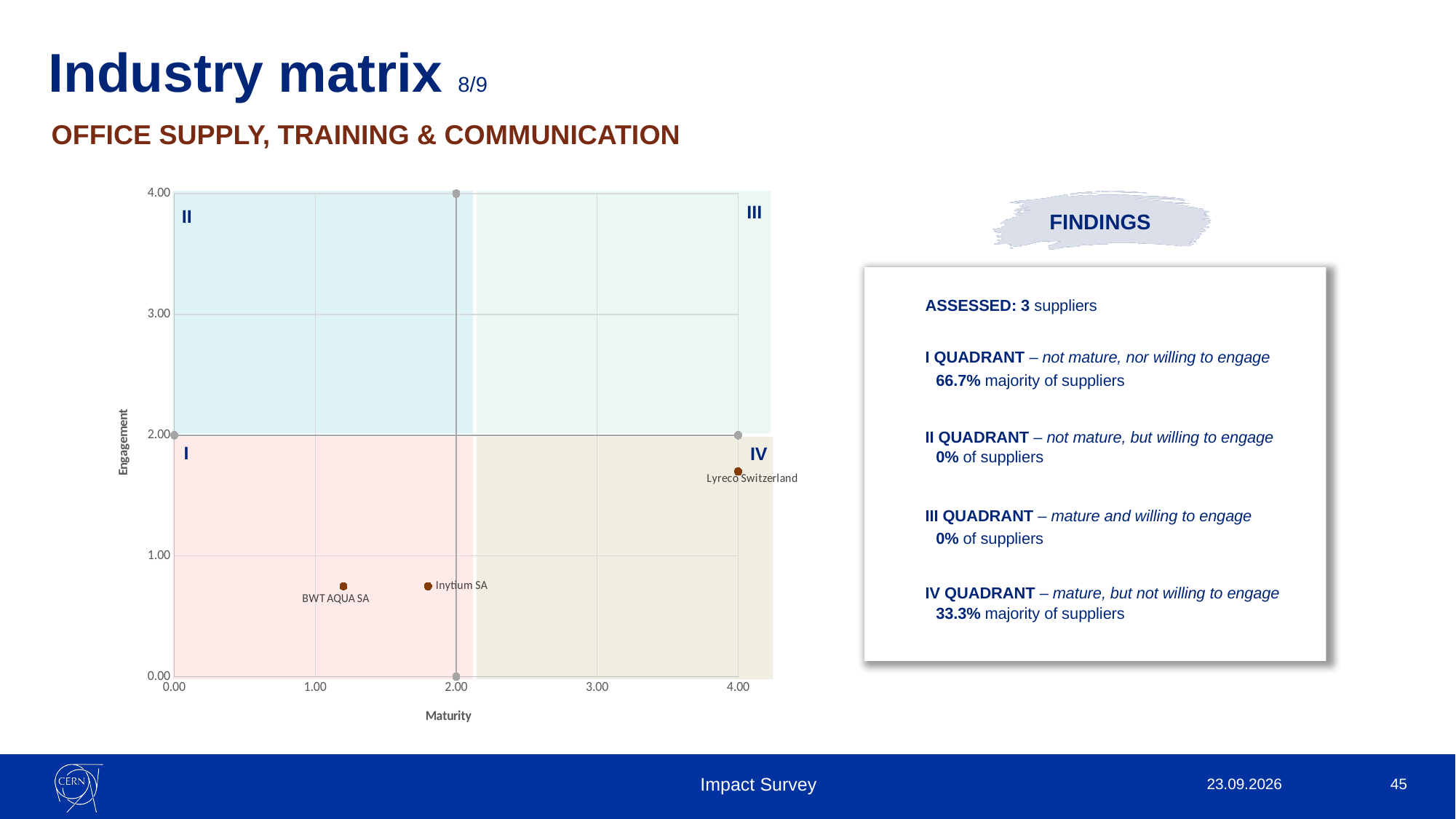
Is the Maturity value for BWT AQUA SA greater or less than 2.00? less How many suppliers are plotted on the chart? 3 Is the Maturity value for Lyreco Switzerland greater or less than 3.00? greater Which supplier has the highest Maturity value? Lyreco Switzerland Is the Engagement value for Inytium SA greater or less than 1.00? less What kind of chart is shown on the slide? Scatter chart Which supplier has the lowest Maturity value? BWT AQUA SA Which supplier has the highest Engagement value? Lyreco Switzerland Which supplier has a higher Maturity value, Inytium SA or BWT AQUA SA? Inytium SA What is the label of the y axis of the chart? Engagement What is the label of the x axis of the chart? Maturity